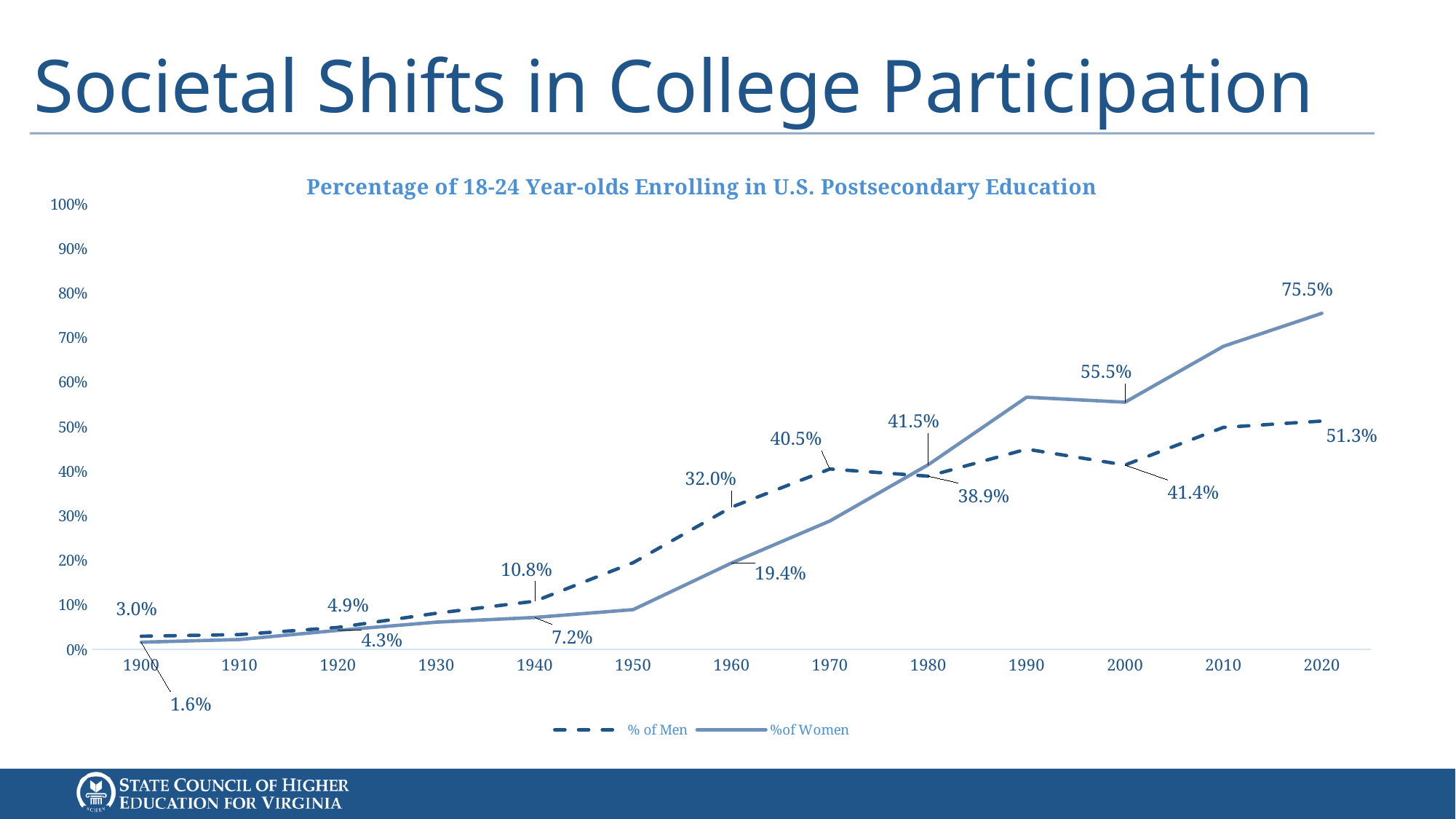
What kind of chart is shown on the slide? Line chart What is the value for % of Men in 1940? 10.8% In which year does the % of Men series reach its highest value? 2020 In 1960, which is larger: % of Men or % of Women? % of Men What is the value for % of Men in 2020? 51.3% How many years are shown on the x axis? 13 In 2000, which is larger: % of Men or % of Women? % of Women What is the difference between the % of Women and % of Men values in 2020? 24.2 percentage points What is the value for % of Women in 1900? 1.6% What is the value for % of Women in 2020? 75.5% How many series does the legend list? 2 Is the value for % of Women in 1990 greater or less than 50%? greater